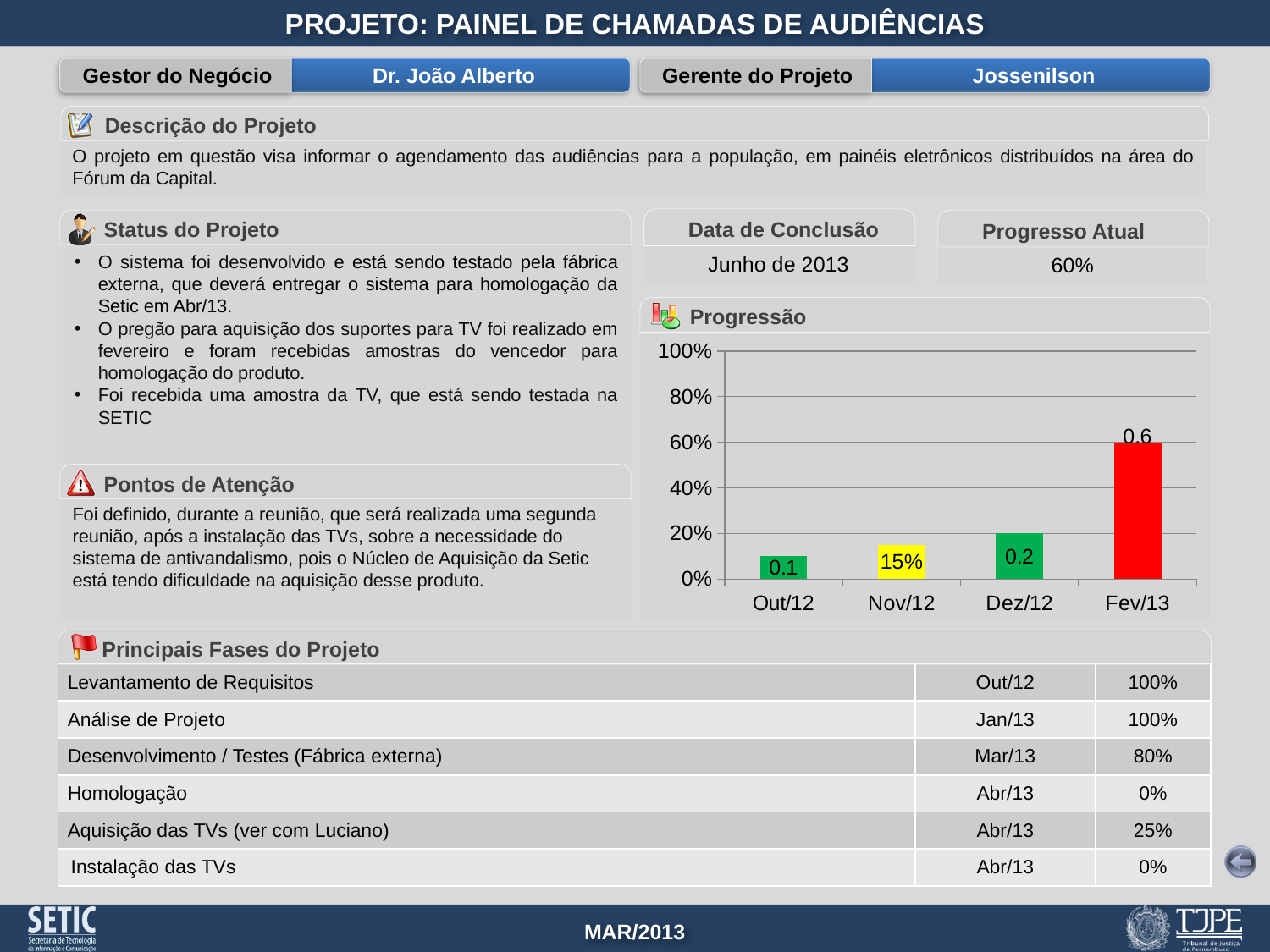
In the Progressão chart, which is larger: the value for Dez/12 or the value for Out/12? Dez/12 What kind of chart is the Progressão chart? Bar chart What is the value shown for Fev/13 in the Progressão chart? 0.6 Which month has the highest value in the Progressão chart? Fev/13 What is the value shown for Nov/12 in the Progressão chart? 15% How many months are shown on the x axis of the Progressão chart? 4 Do the values in the Progressão chart rise or fall from Out/12 to Fev/13? Rise What is the value shown for Out/12 in the Progressão chart? 0.1 Which month has the lowest value in the Progressão chart? Out/12 Is the value for Fev/13 in the Progressão chart greater or less than 40%? greater What is the value shown for Dez/12 in the Progressão chart? 0.2 What is the difference between the values for Fev/13 and Dez/12 in the Progressão chart? 0.4